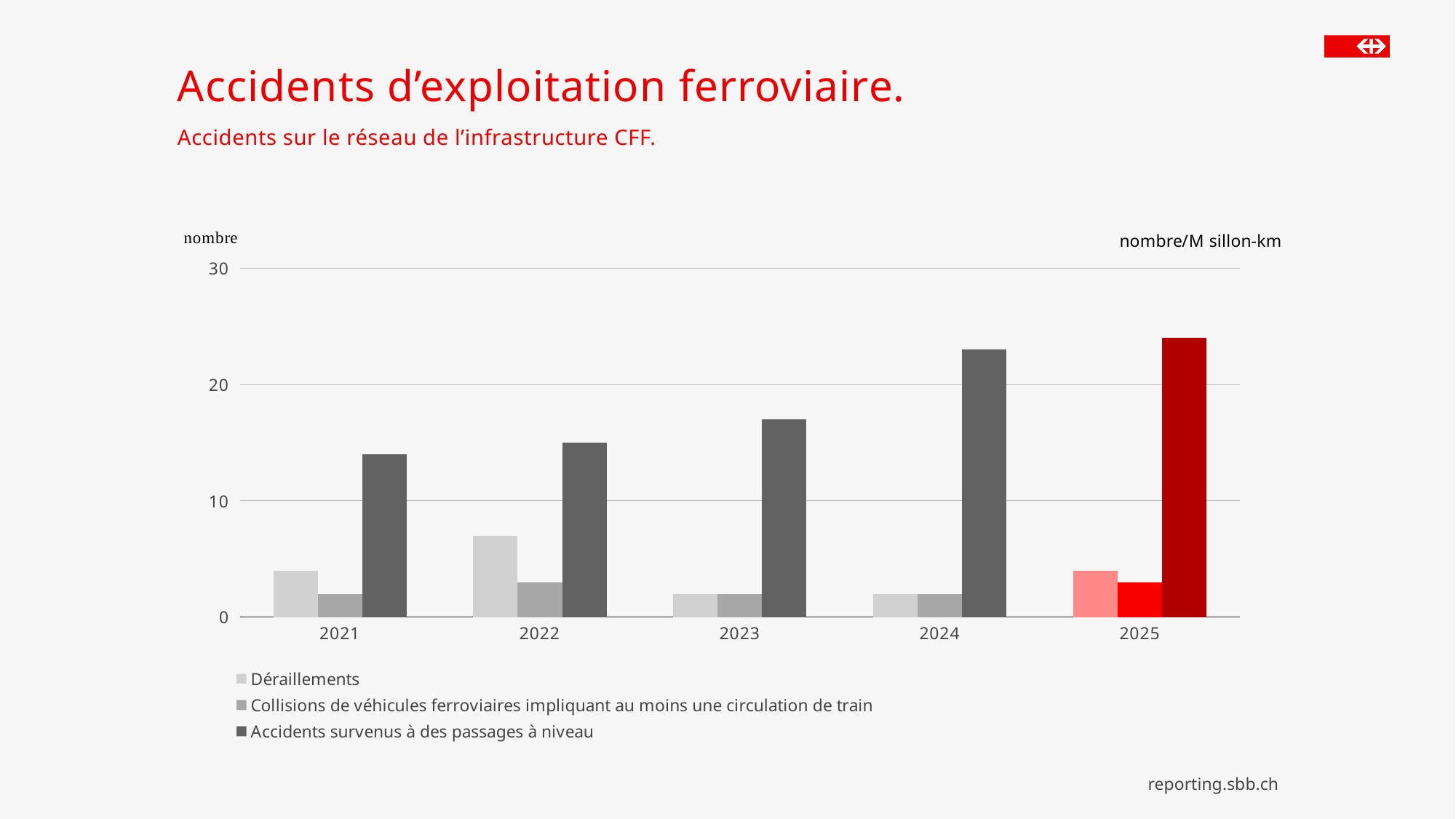
Is the value for 'Accidents survenus à des passages à niveau' in 2024 greater or less than 20? greater How many series does the chart's legend list? 3 What kind of chart is shown on the slide? bar chart How many years are shown on the x axis of the chart? 5 Which year has the larger value for 'Accidents survenus à des passages à niveau', 2021 or 2024? 2024 Is the value for 'Accidents survenus à des passages à niveau' in 2023 greater or less than 20? less Which year has the larger value for 'Déraillements', 2021 or 2022? 2022 Is the value for 'Déraillements' in 2022 greater or less than 10? less Which year's bars are highlighted in red on the chart? 2025 Do the values for 'Accidents survenus à des passages à niveau' rise or fall from 2021 to 2025? rise In which year is the value for 'Déraillements' highest? 2022